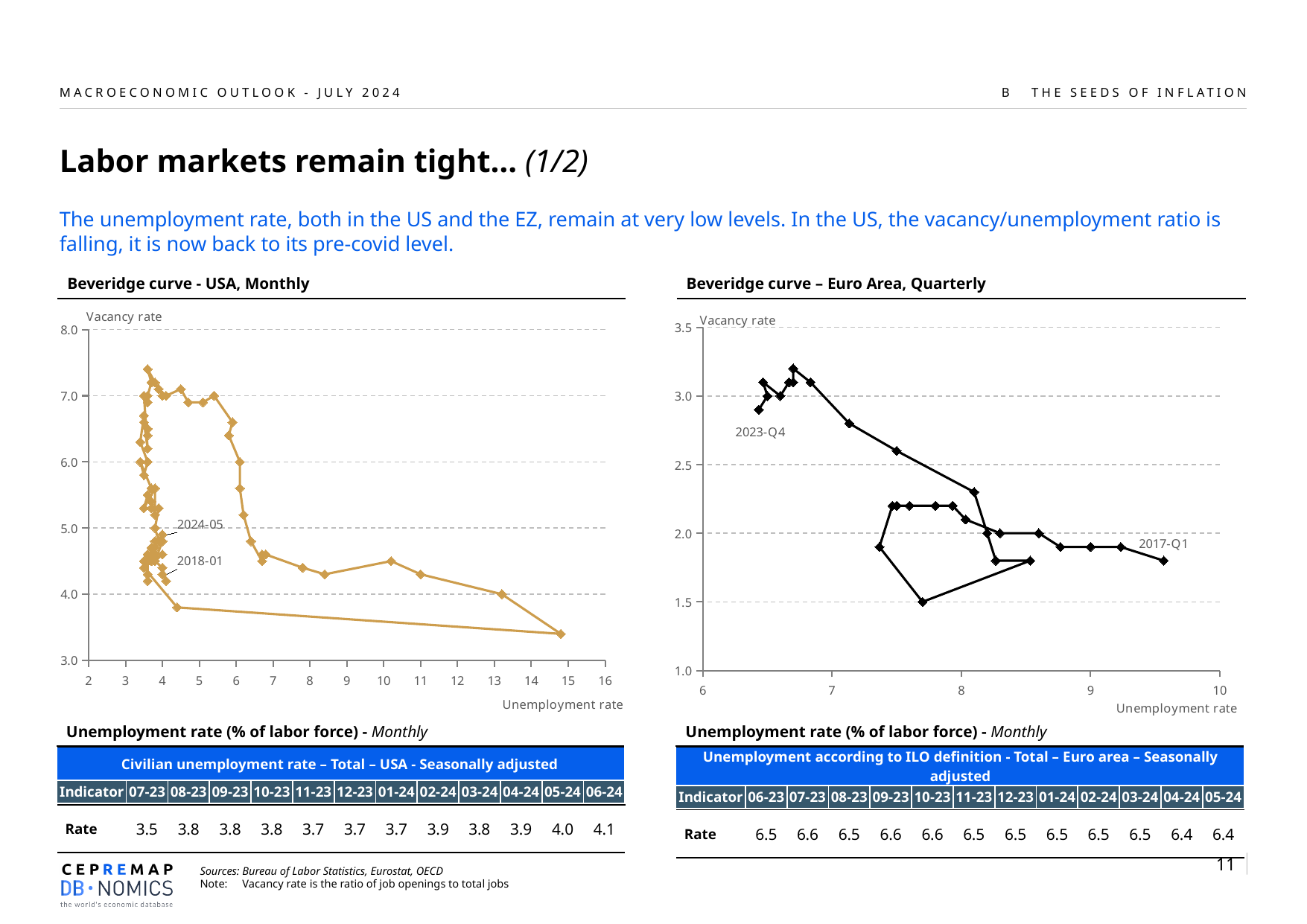
In the 'Beveridge curve – Euro Area, Quarterly' chart, is the unemployment rate of the point labelled 2017-Q1 greater or less than 9? greater In the 'Beveridge curve – Euro Area, Quarterly' chart, is the vacancy rate of the point labelled 2023-Q4 greater or less than 2.5? greater In the 'Beveridge curve – Euro Area, Quarterly' chart, is the vacancy rate of the point labelled 2017-Q1 greater or less than 2.0? less What is the title of the chart on the right side of the slide? Beveridge curve – Euro Area, Quarterly What is the title of the chart on the left side of the slide? Beveridge curve - USA, Monthly In the 'Beveridge curve – Euro Area, Quarterly' chart, which labelled point has the higher vacancy rate, 2017-Q1 or 2023-Q4? 2023-Q4 What kind of chart is the 'Beveridge curve – Euro Area, Quarterly' chart? line chart In the 'Beveridge curve - USA, Monthly' chart, what variable is plotted on the horizontal axis? Unemployment rate